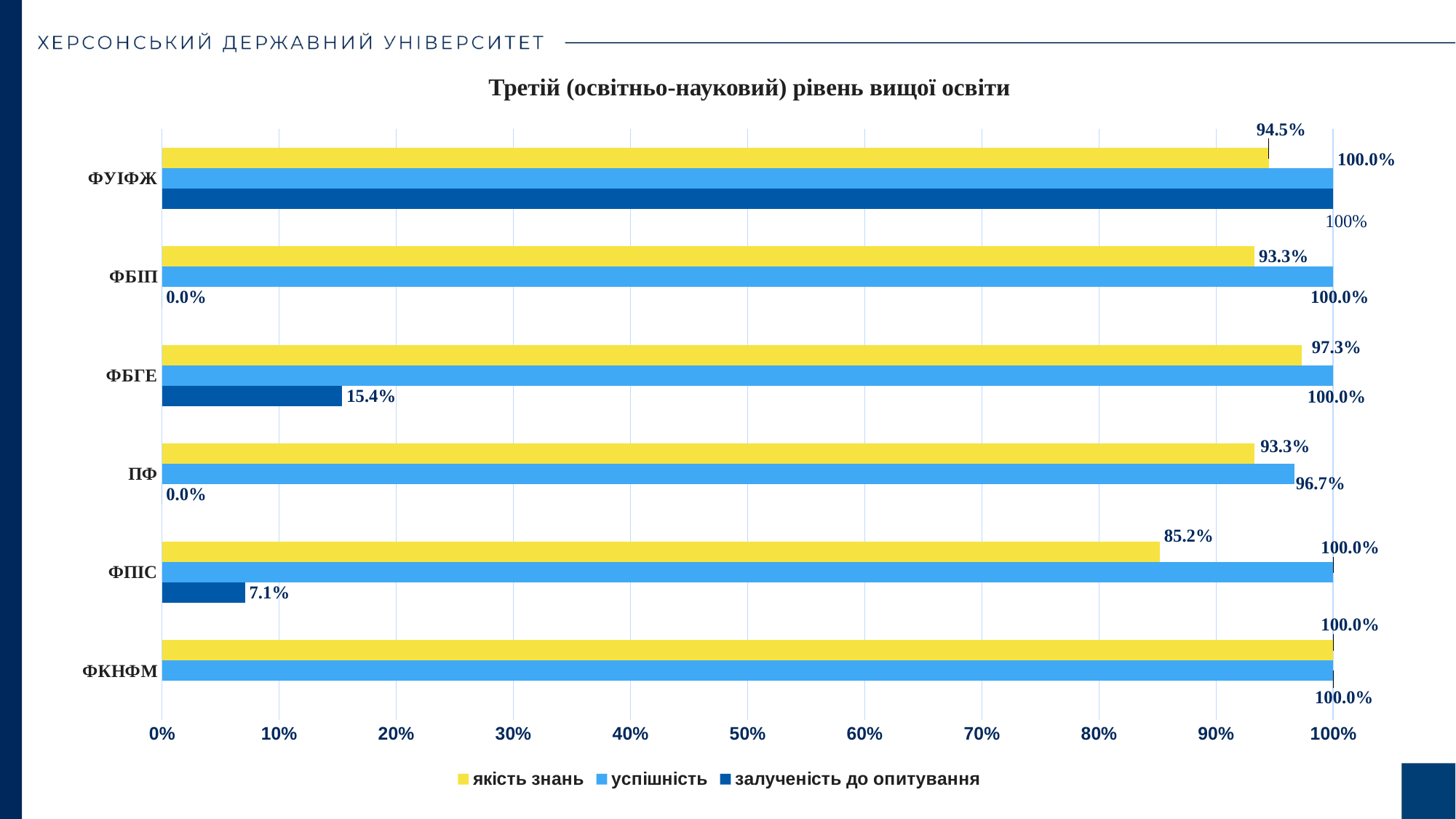
Which category has the lowest якість знань value? ФПІС What is the залученість до опитування value for ФБГЕ? 15.4% What is the якість знань value for ФПІС? 85.2% Is the залученість до опитування value for ФБГЕ greater or less than 20%? less What kind of chart is shown on the slide? bar chart How many categories are shown on the y axis? 6 What is the успішність value for ПФ? 96.7% What is the difference between the якість знань values for ФБГЕ and ФПІС? 12.1 percentage points Which has the larger залученість до опитування value, ФБГЕ or ФПІС? ФБГЕ How many series does the legend list? 3 Which category has the highest якість знань value? ФКНФМ